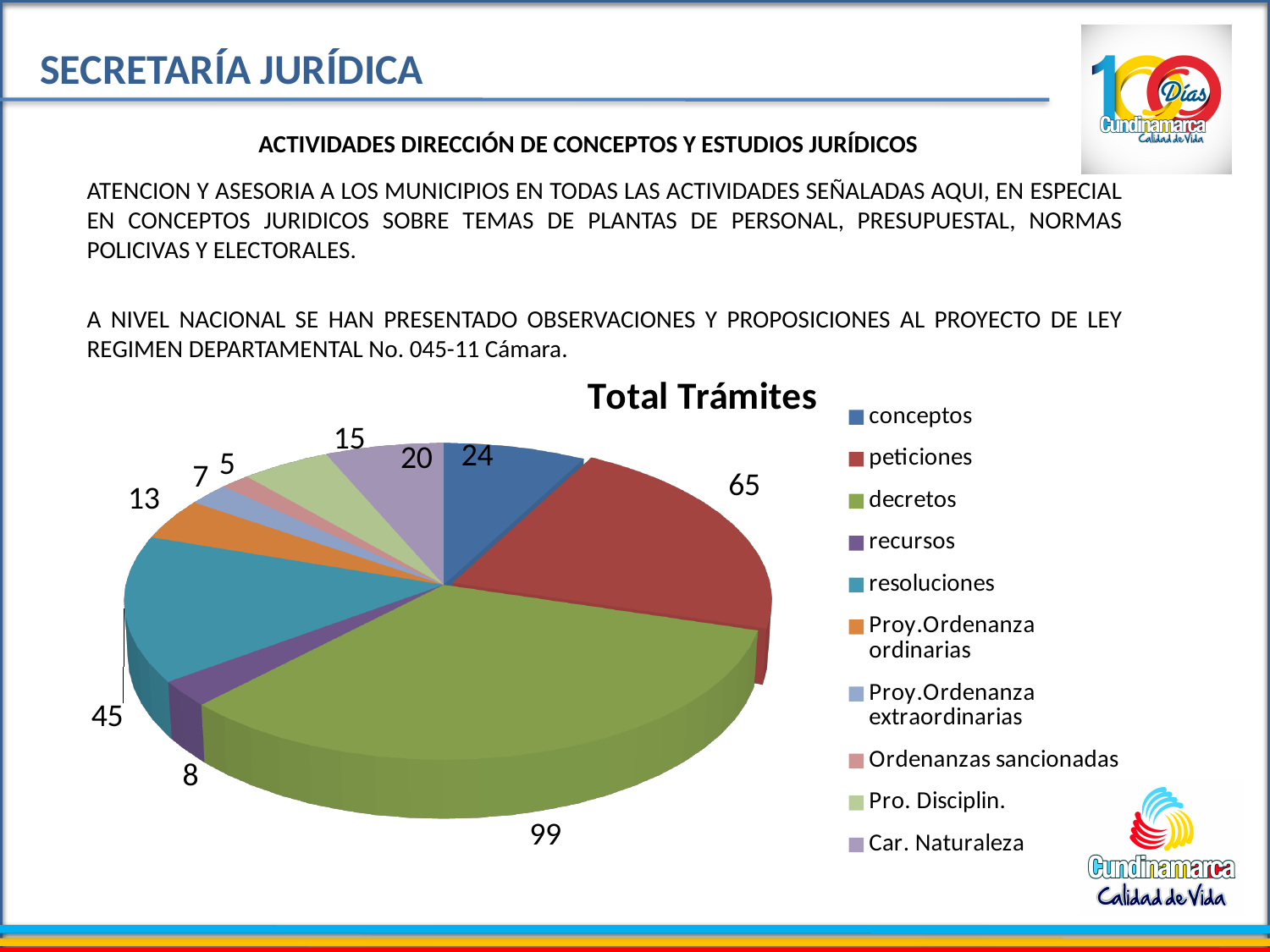
What is the value for Car. Naturaleza in the Total Trámites chart? 20 Which category has the largest slice in the Total Trámites chart? decretos What is the value for decretos in the Total Trámites chart? 99 What type of chart is shown under the title 'Total Trámites'? pie chart What is the difference between the values for Pro. Disciplin. and recursos in the Total Trámites chart? 7 Which category has the smallest slice in the Total Trámites chart? Ordenanzas sancionadas What is the value for peticiones in the Total Trámites chart? 65 Which is larger in the Total Trámites chart, conceptos or resoluciones? resoluciones What is the difference between the values for decretos and peticiones in the Total Trámites chart? 34 What is the value for resoluciones in the Total Trámites chart? 45 How many categories does the Total Trámites pie chart have? 10 What is the title of the pie chart on the slide? Total Trámites